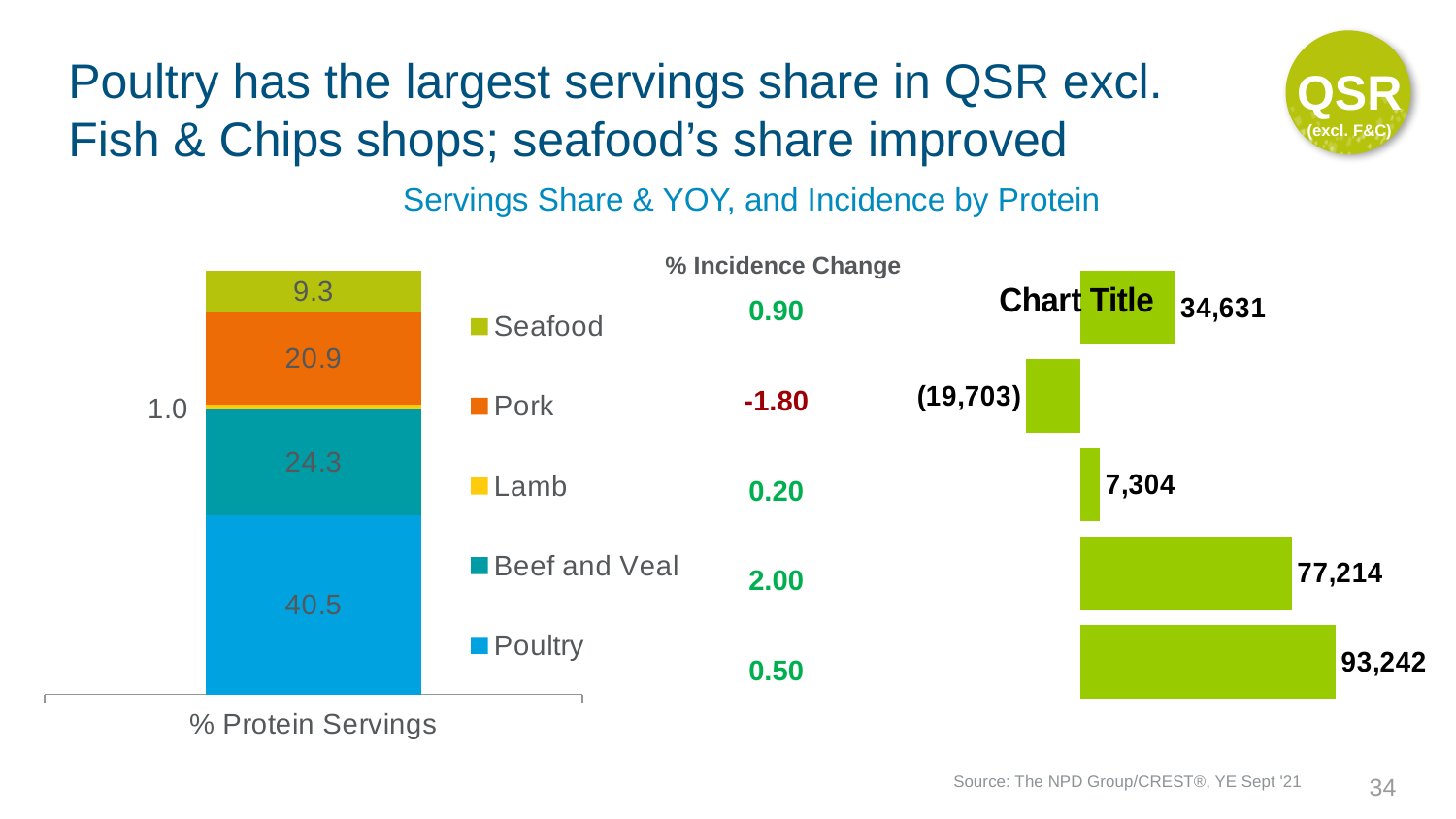
In the bar chart on the right, what is the value for the bar in the Pork row? (19,703) What type of chart is shown on the left of the slide? Stacked bar chart How many series does the legend list? 5 In the stacked bar chart on the left, what is the value for Beef and Veal? 24.3 In the stacked bar chart on the left, what is the value for Seafood? 9.3 In the bar chart on the right, what is the value for the bar in the Poultry row? 93,242 In the stacked bar chart on the left, what is the value for Poultry? 40.5 What is the title shown on the bar chart on the right? Chart Title In the stacked bar chart on the left, what is the difference between the Poultry and Pork values? 19.6 In the bar chart on the right, which row has the smallest bar value? Pork In the stacked bar chart on the left, which protein has the largest segment? Poultry In the stacked bar chart on the left, which is larger, the Pork segment or the Beef and Veal segment? Beef and Veal